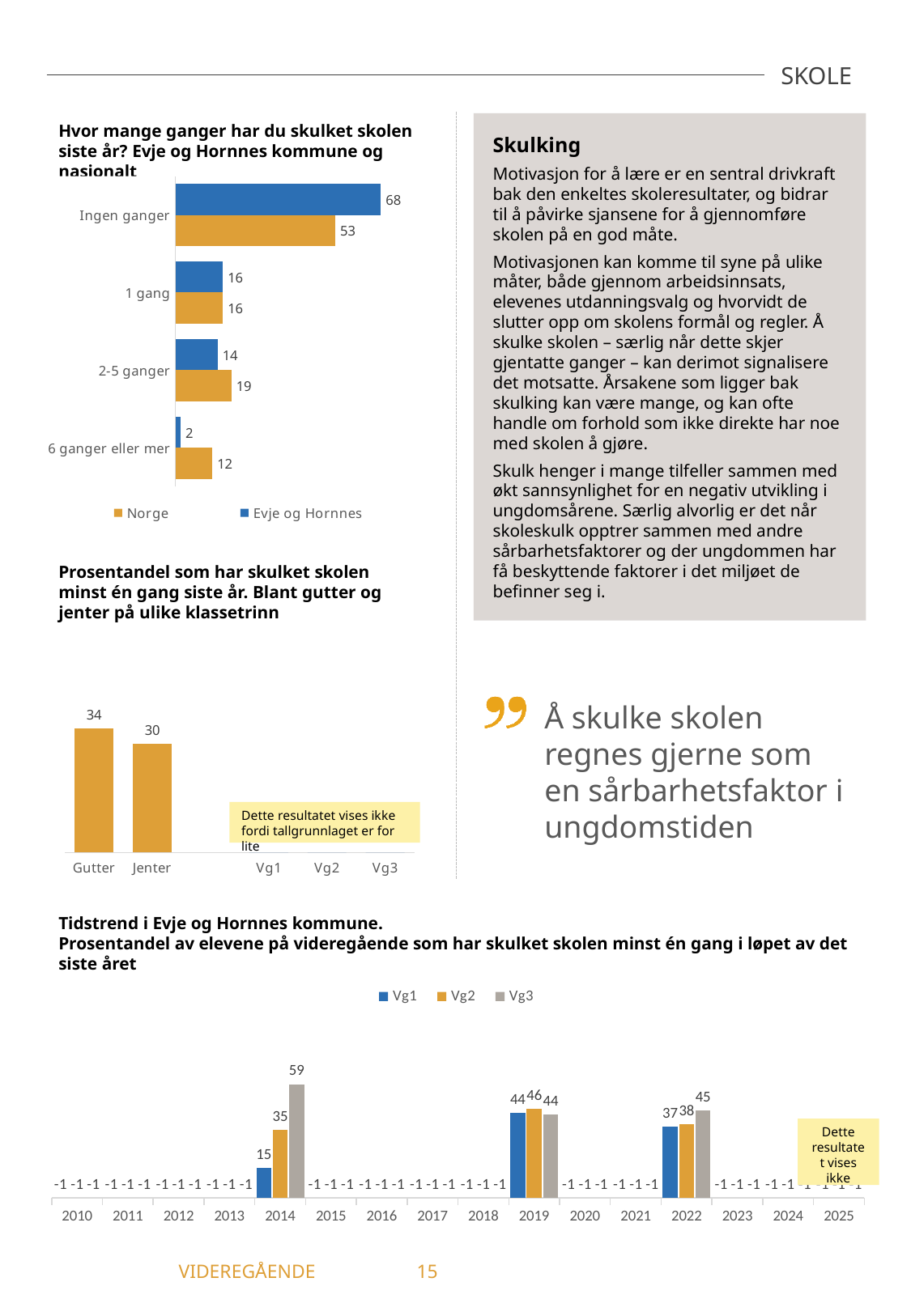
In the chart 'Hvor mange ganger har du skulket skolen siste år?', what is the value for Norge in the '6 ganger eller mer' category? 12 In the chart 'Hvor mange ganger har du skulket skolen siste år?', what is the difference between Evje og Hornnes and Norge for 'Ingen ganger'? 15 In the chart 'Prosentandel som har skulket skolen minst én gang siste år', what is the value for Gutter? 34 In the chart 'Tidstrend i Evje og Hornnes kommune', what is the value for Vg3 in 2014? 59 In the chart 'Tidstrend i Evje og Hornnes kommune', which series has the highest value in 2014? Vg3 In the chart 'Hvor mange ganger har du skulket skolen siste år?', which is larger for '2-5 ganger': Norge or Evje og Hornnes? Norge In the chart 'Hvor mange ganger har du skulket skolen siste år?', how many categories are shown? 4 In the chart 'Tidstrend i Evje og Hornnes kommune', what is the value for Vg1 in 2022? 37 In the chart 'Hvor mange ganger har du skulket skolen siste år?', how many series does the legend list? 2 In the chart 'Prosentandel som har skulket skolen minst én gang siste år', what is the difference between Gutter and Jenter? 4 In the chart 'Hvor mange ganger har du skulket skolen siste år?', what is the value for Evje og Hornnes in the 'Ingen ganger' category? 68 What kind of chart is the 'Tidstrend i Evje og Hornnes kommune' chart? Bar chart